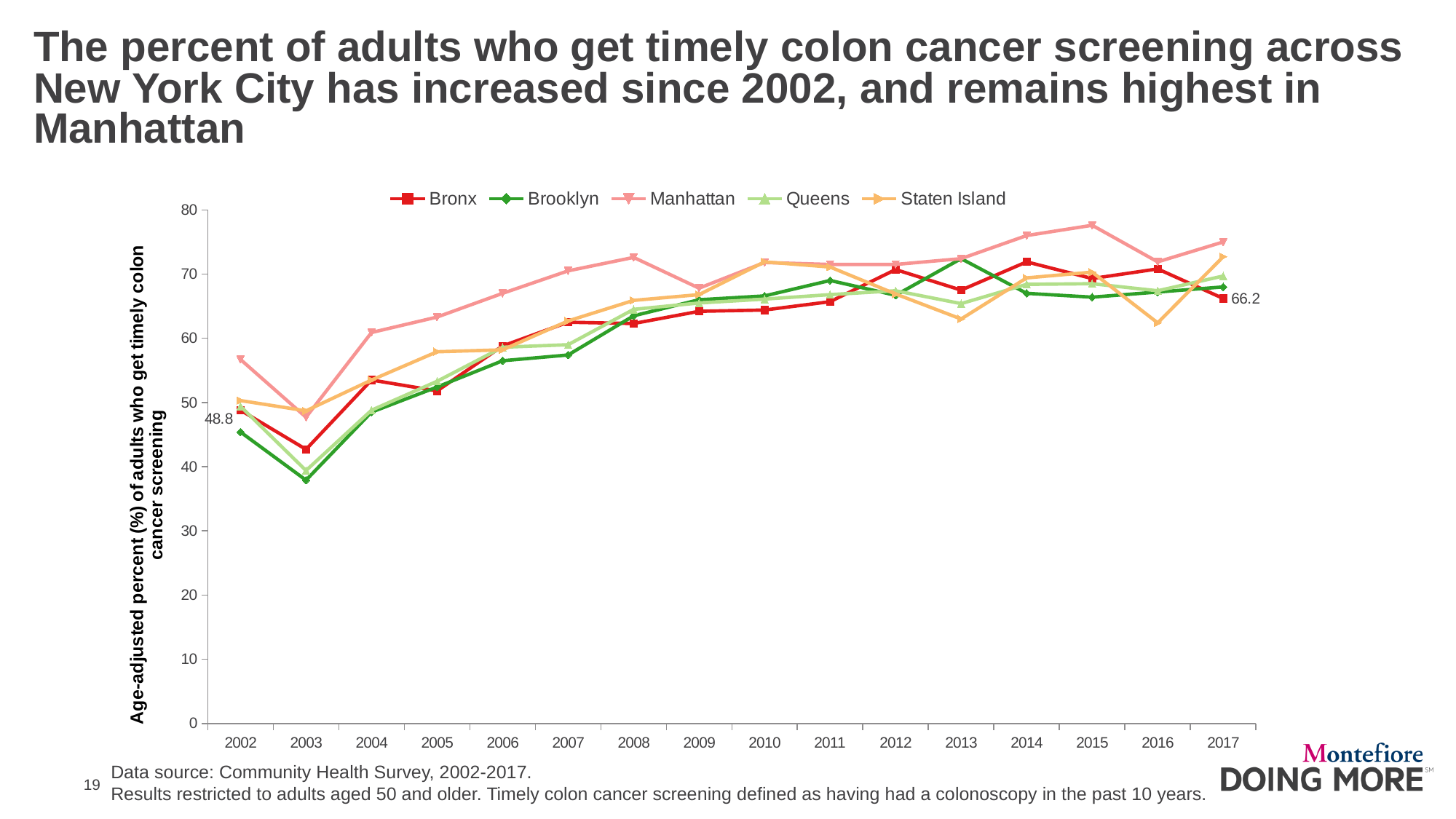
Which borough has the highest value in 2002? Manhattan What is the Bronx value in 2002? 48.8 Is the value for Brooklyn in 2003 greater or less than 40? less How many series does the legend list? 5 How many years are plotted along the x axis? 16 By how much did the Bronx value increase from 2002 to 2017? 17.4 Does the Bronx line generally rise or fall from 2002 to 2017? rise Which borough has the highest value in 2017? Manhattan Is the value for Manhattan in 2015 greater or less than 70? greater What is the Bronx value in 2017? 66.2 Which is larger in 2015, the value for Manhattan or the value for Bronx? Manhattan What type of chart is shown on the slide? line chart